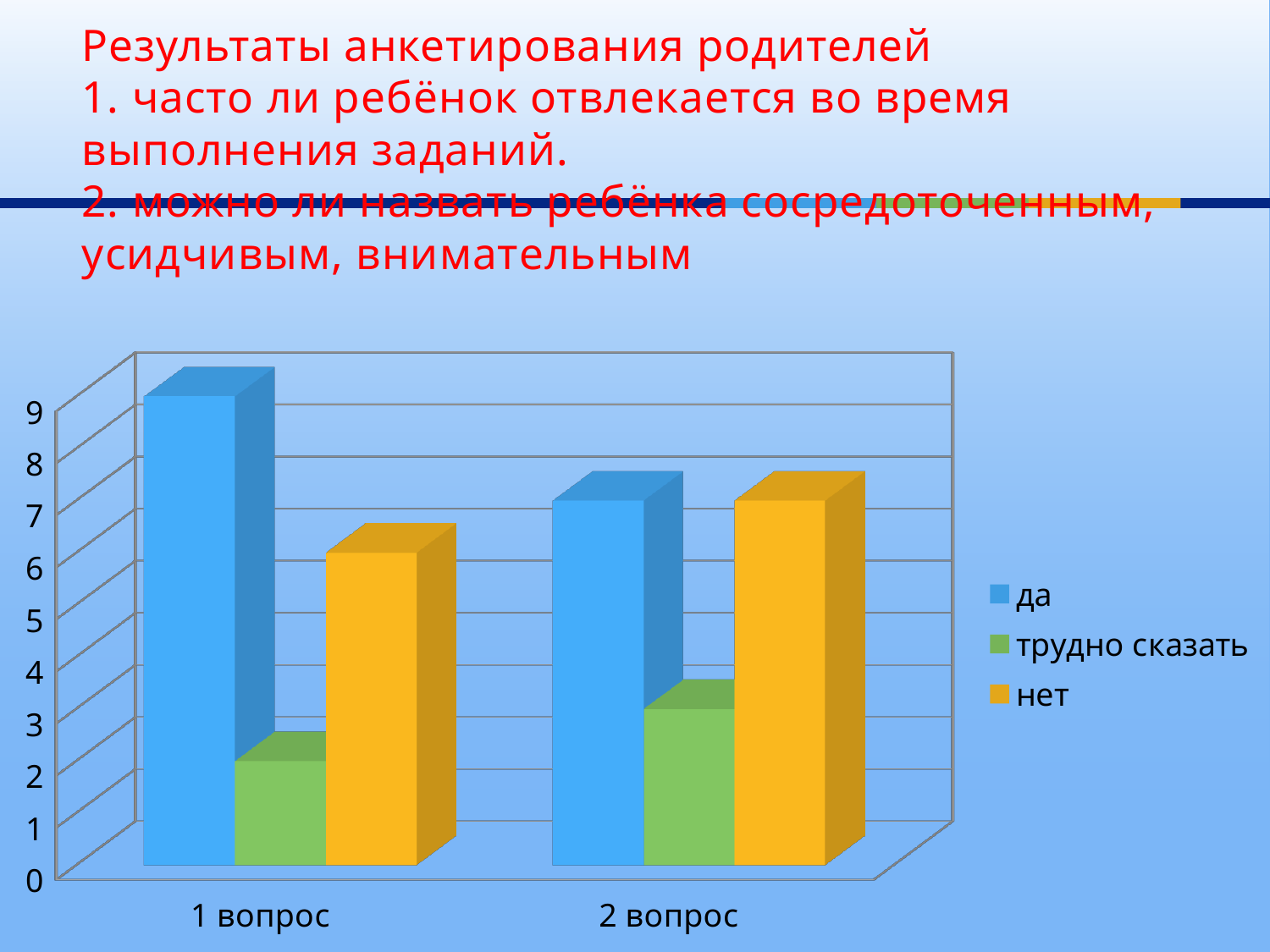
How many series does the chart legend list? 3 Is the value for "да" in "2 вопрос" greater or less than 5? greater How many categories are shown on the x axis of the chart? 2 In "1 вопрос", which is larger: the value for "да" or the value for "нет"? да Is the value for "трудно сказать" in "2 вопрос" greater or less than 5? less Is the value for "да" in "1 вопрос" greater or less than 8? greater Which colour represents the "нет" series in the chart legend? yellow Which series has the lowest value in "2 вопрос"? трудно сказать Which series has the highest value in "1 вопрос"? да What kind of chart is shown on the slide? bar chart